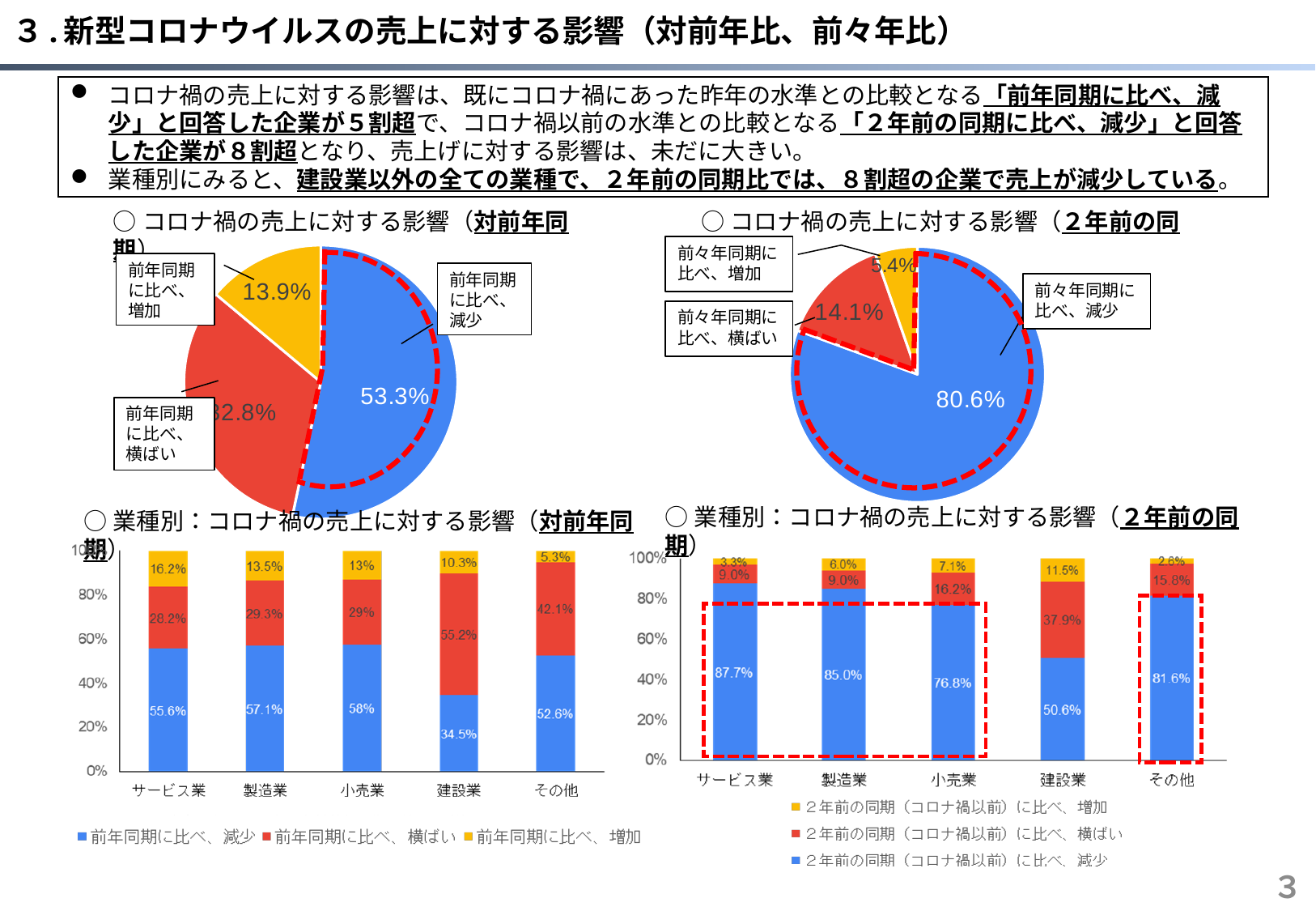
In the bottom-right bar chart (業種別 ２年前の同期), what is the value of ２年前の同期に比べ、減少 for サービス業? 87.7% In the bottom-left bar chart (業種別 対前年同期), which industry has the highest 前年同期に比べ、横ばい value? 建設業 In the top-right pie chart (２年前の同期), which category has the smallest slice? 前々年同期に比べ、増加 In the bottom-right bar chart (業種別 ２年前の同期), is the 減少 value for 小売業 larger or smaller than that for その他? smaller In the top-left pie chart (コロナ禍の売上に対する影響 対前年同期), what share of companies answered 前年同期に比べ、減少? 53.3% What is the difference between the 減少 share in the top-right pie chart (80.6%) and the 減少 share in the top-left pie chart (53.3%)? 27.3 percentage points In the bottom-left bar chart (業種別 対前年同期), how many industry categories are shown on the x axis? 5 In the bottom-left bar chart (業種別 対前年同期), what is the value of 前年同期に比べ、減少 for 建設業? 34.5% In the top-right pie chart (２年前の同期), what share of companies answered 前々年同期に比べ、減少? 80.6% In the bottom-right bar chart (業種別 ２年前の同期), which industry has the lowest ２年前の同期に比べ、減少 value? 建設業 How many series does the legend of the bottom-right bar chart (業種別 ２年前の同期) list? 3 In the top-left pie chart (対前年同期), what percentage answered 前年同期に比べ、増加? 13.9%